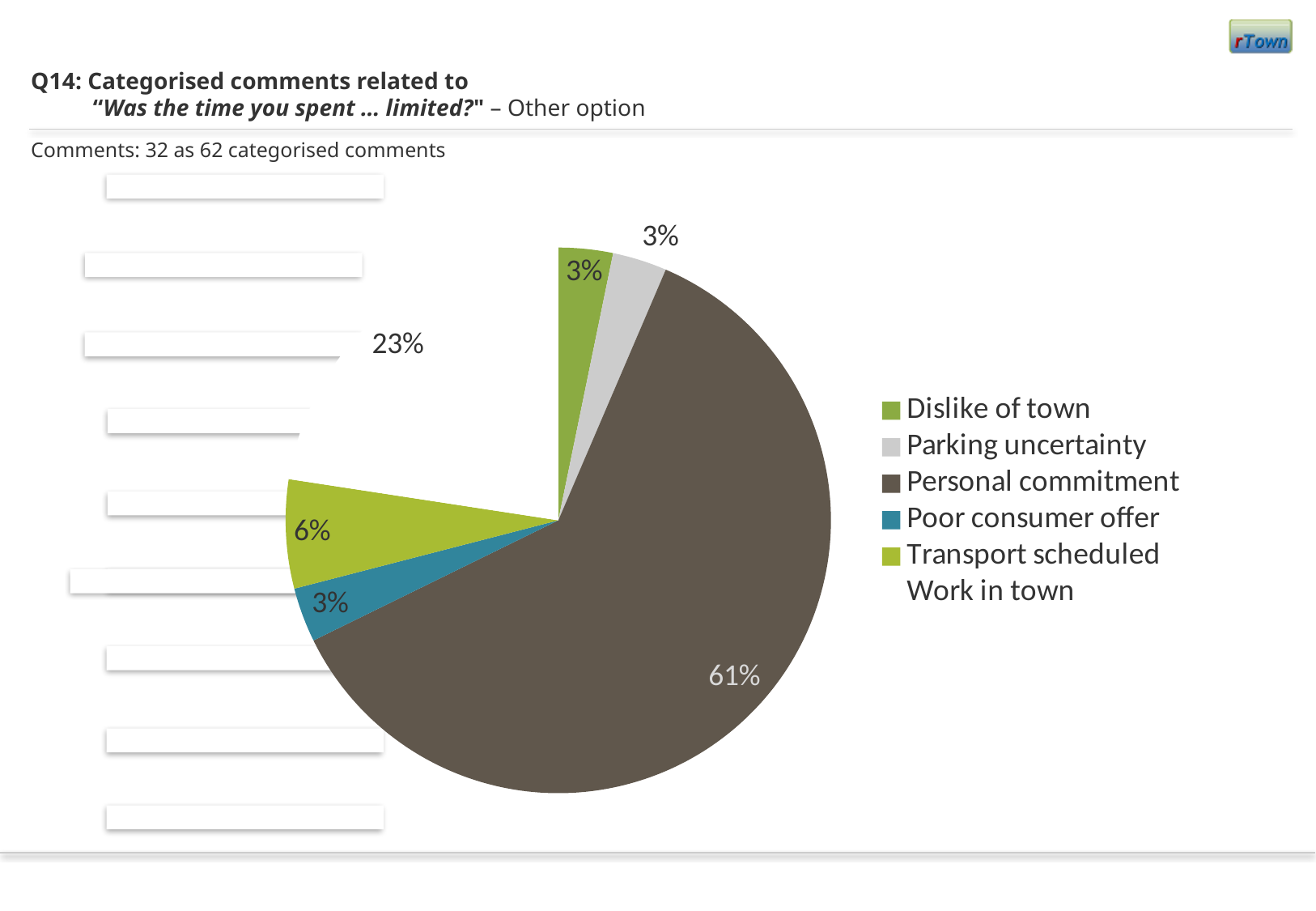
What percentage of the pie is Personal commitment? 61% What percentage of the pie is Dislike of town? 3% What kind of chart is shown on the slide? Pie chart What percentage of the pie is Work in town? 23% How many categories does the legend list? 6 What percentage of the pie is Transport scheduled? 6% What is the difference in percentage points between Personal commitment and Transport scheduled? 55 percentage points Is the share for Personal commitment greater or less than 50%? greater Which category has the largest share of the pie? Personal commitment What percentage of the pie is Poor consumer offer? 3% According to the text above the chart, how many comments were categorised? 32 as 62 categorised comments Which has the larger share, Transport scheduled or Poor consumer offer? Transport scheduled